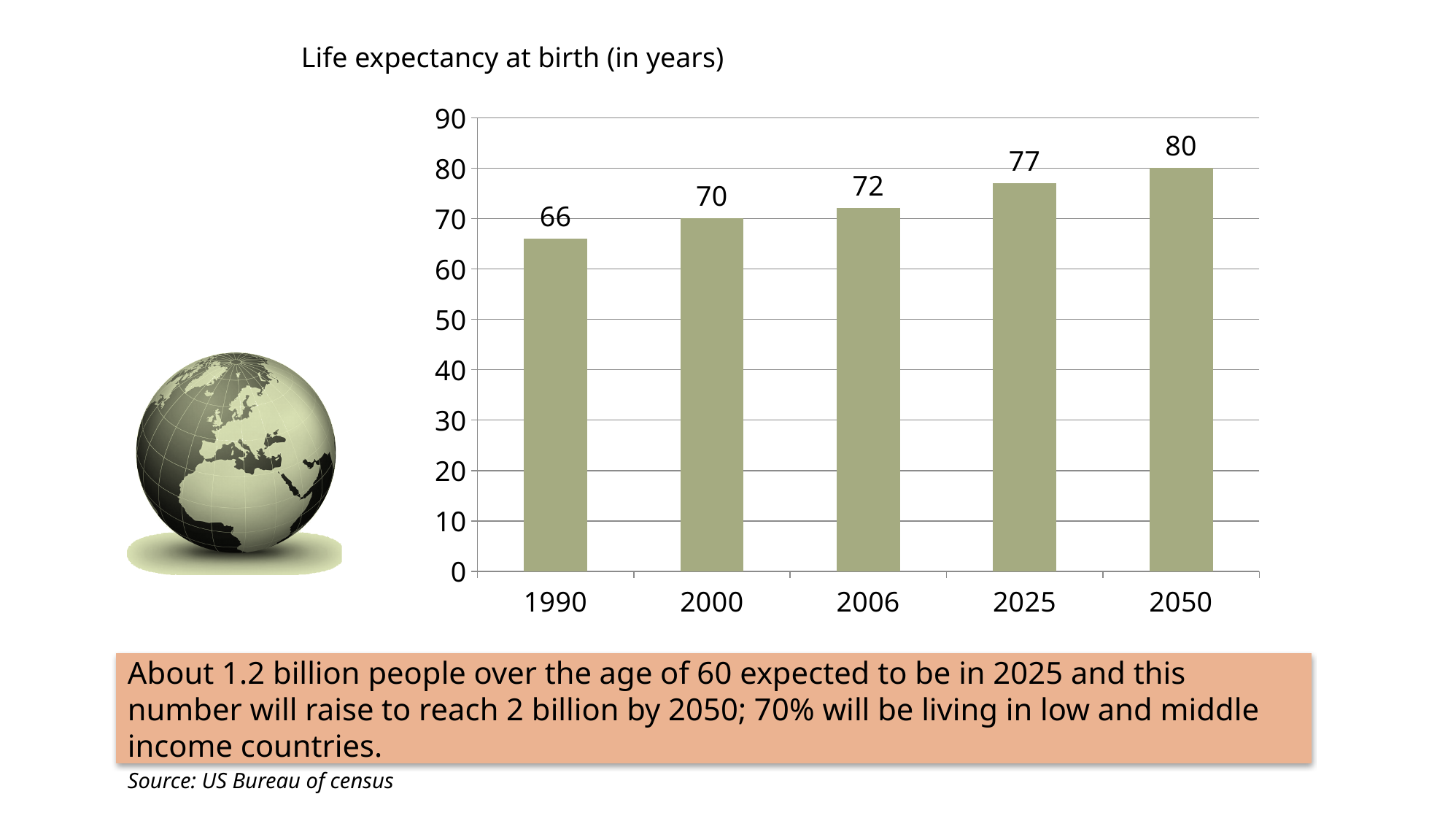
Which year has the highest life expectancy at birth? 2050 Does life expectancy at birth rise or fall from 1990 to 2050? Rise What is the life expectancy at birth shown for 1990? 66 Which year has a higher life expectancy, 2000 or 2025? 2025 What kind of chart is used to show life expectancy at birth? Bar chart Is the life expectancy for 2006 greater or less than 70? greater How many years are shown on the x axis of the chart? 5 What is the life expectancy at birth shown for 2050? 80 What is the life expectancy at birth shown for 2006? 72 What is the difference in life expectancy between 2025 and 2000? 7 What is the difference in life expectancy between 2050 and 1990? 14 Which year has the lowest life expectancy at birth? 1990